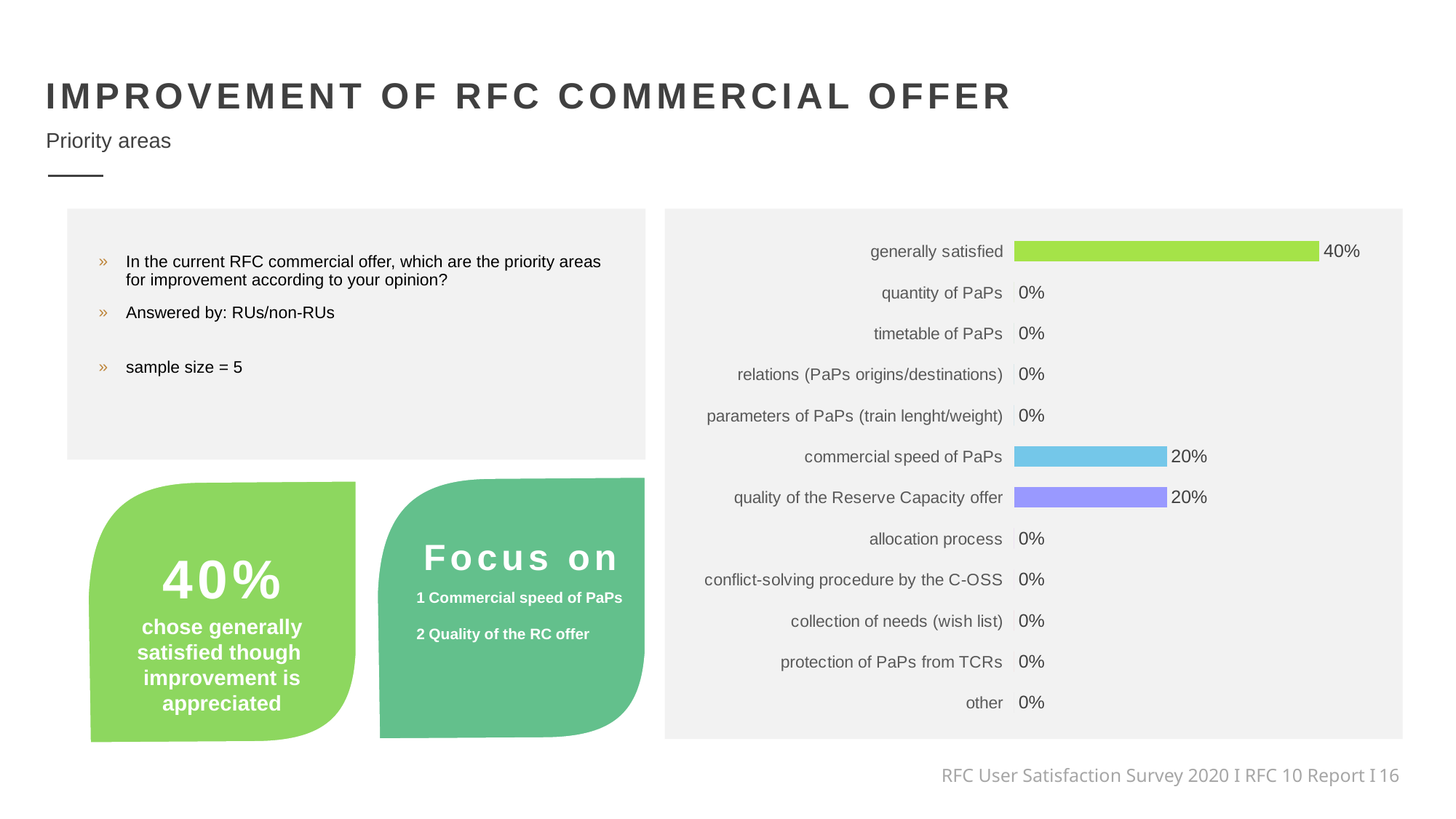
What is the value for 'protection of PaPs from TCRs'? 0% Which category has the highest value? generally satisfied What colour is the bar for 'generally satisfied'? green How many categories are shown in the chart? 12 What is the value for 'generally satisfied'? 40% How many categories have a value of 0%? 9 What is the value for 'allocation process'? 0% What kind of chart is shown on the slide? bar chart What is the value for 'quality of the Reserve Capacity offer'? 20% Which is larger, the value for 'generally satisfied' or the value for 'quality of the Reserve Capacity offer'? generally satisfied What is the value for 'commercial speed of PaPs'? 20% What is the difference between the values for 'generally satisfied' and 'commercial speed of PaPs'? 20%